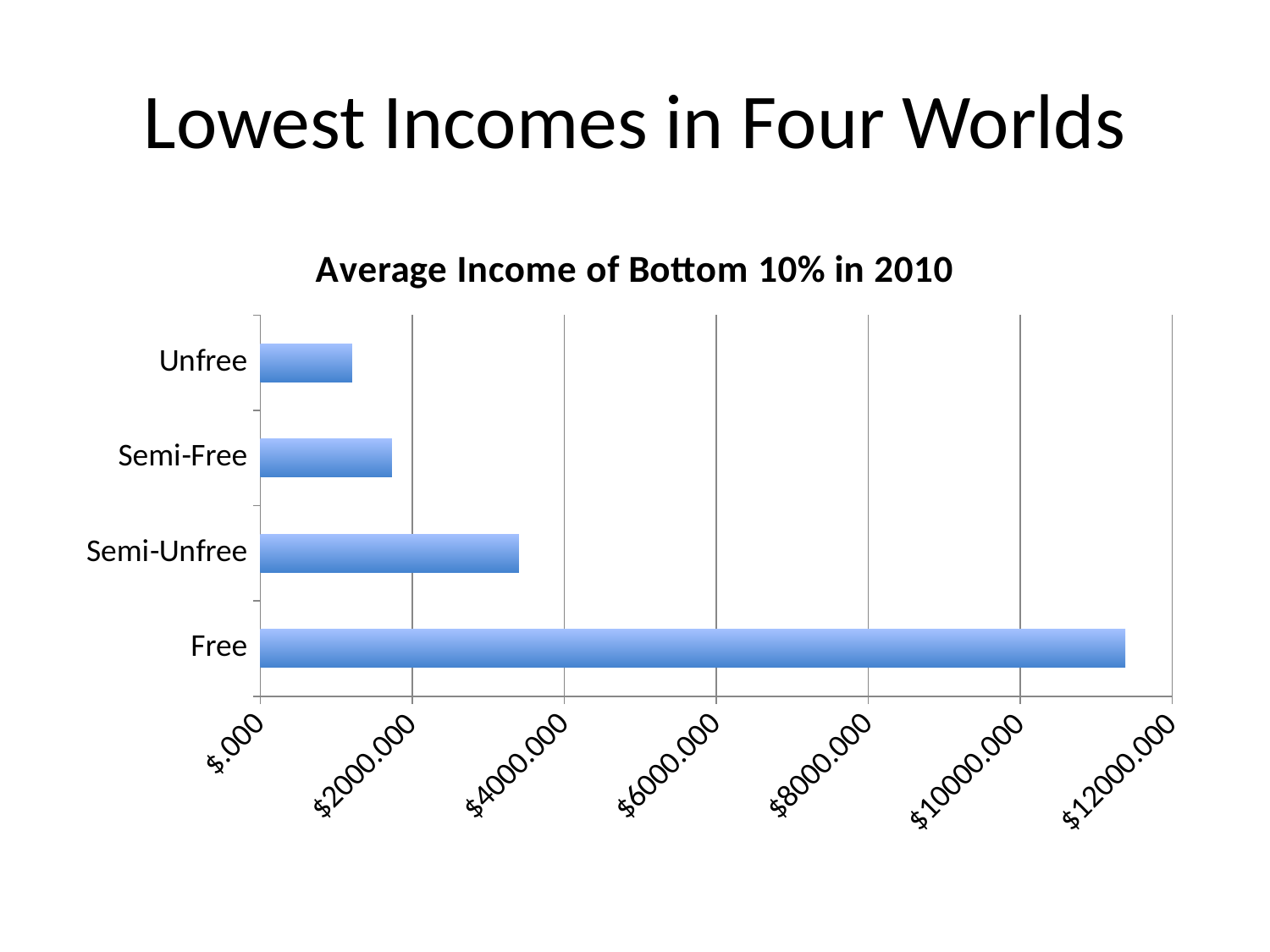
Which category has the highest average income of the bottom 10%? Free How many categories are plotted in the chart? 4 What colour are the bars in the chart? blue Which has a larger value, Semi-Unfree or Semi-Free? Semi-Unfree Is the value for Semi-Unfree greater or less than $4000.000? less Which category has the lowest average income of the bottom 10%? Unfree Is the value for Free greater or less than $10000.000? greater What is the title of the chart? Average Income of Bottom 10% in 2010 Is the value for Unfree greater or less than $2000.000? less Which has a larger value, Free or Semi-Unfree? Free What kind of chart is shown on the slide? bar chart